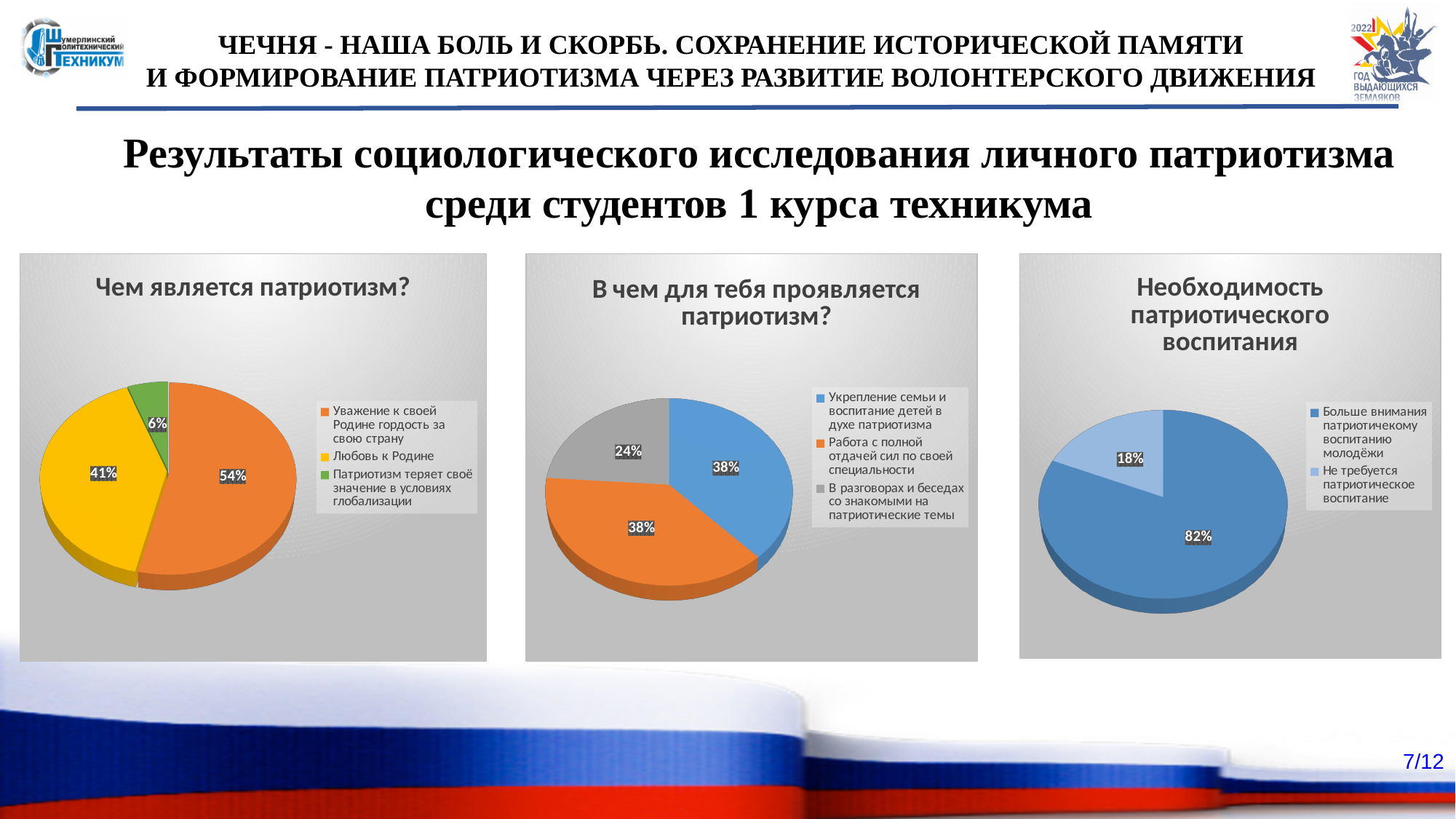
In the chart titled "В чем для тебя проявляется патриотизм?", what share is labelled "Укрепление семьи и воспитание детей в духе патриотизма"? 38% What type of chart is the chart titled "Необходимость патриотического воспитания"? Pie chart In the chart titled "Необходимость патриотического воспитания", what share is labelled "Не требуется патриотическое воспитание"? 18% In the chart titled "Необходимость патриотического воспитания", which category has the larger slice? Больше внимания патриотичекому воспитанию молодёжи In the chart titled "Чем является патриотизм?", what is the difference in percentage points between the largest and smallest slices? 48 In the chart titled "Чем является патриотизм?", which category has the largest slice? Уважение к своей Родине гордость за свою страну In the chart titled "Чем является патриотизм?", what share of the pie is labelled "Любовь к Родине"? 41% In the chart titled "Необходимость патриотического воспитания", what is the difference in percentage points between the two slices? 64 In the chart titled "В чем для тебя проявляется патриотизм?", which category has the smallest slice? В разговорах и беседах со знакомыми на патриотические темы In the chart titled "Чем является патриотизм?", which category has the smallest slice? Патриотизм теряет своё значение в условиях глобализации In the chart titled "Чем является патриотизм?", how many categories does the legend list? 3